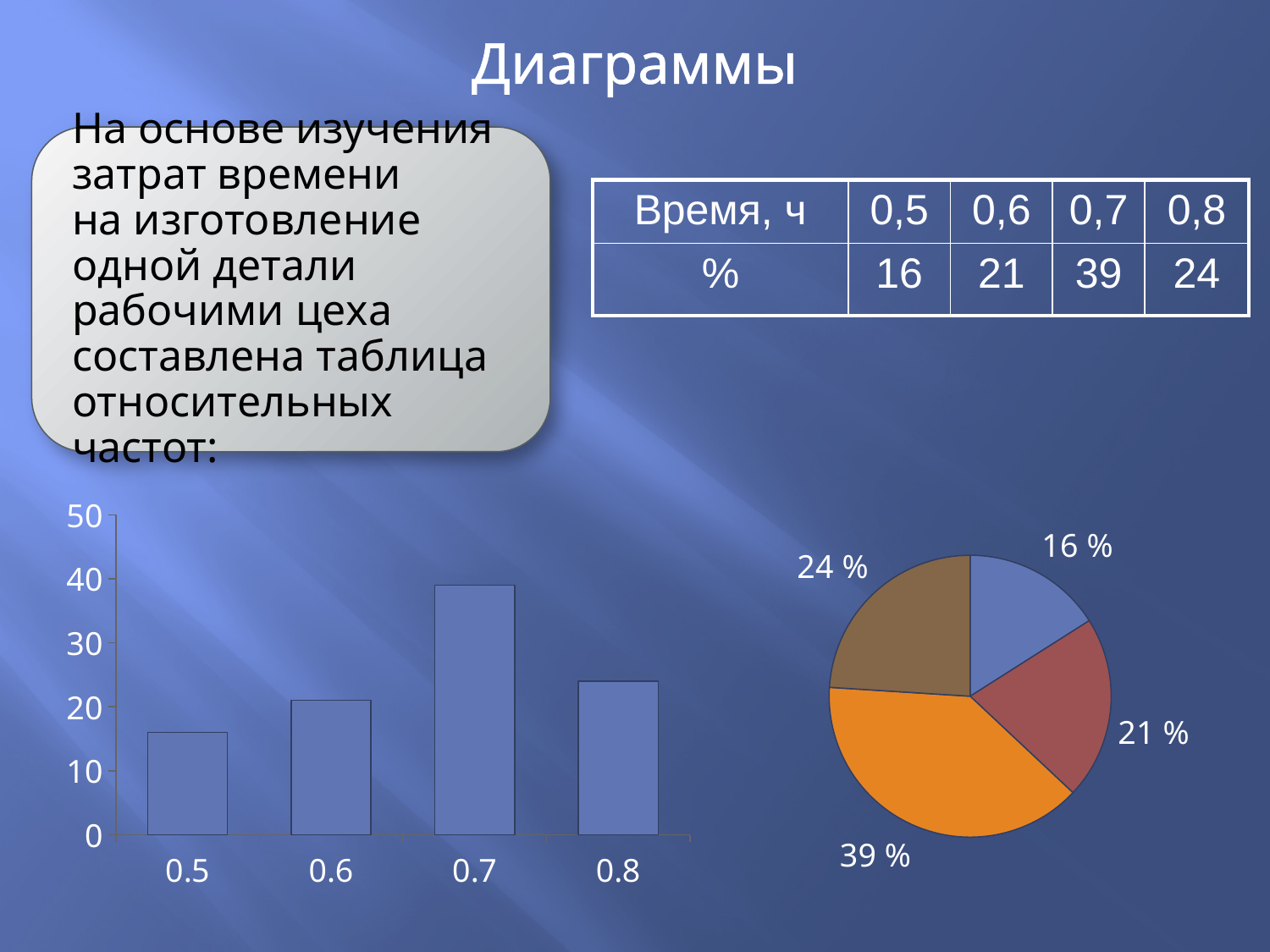
In the pie chart on the bottom right, what is the label of the largest slice? 39 % In the pie chart on the bottom right, what is the label of the smallest slice? 16 % In the bar chart on the bottom left, which category has the shortest bar? 0.5 In the bar chart on the bottom left, how many bars are there? 4 What kind of chart is the chart on the bottom left of the slide? bar chart In the bar chart on the bottom left, is the value for 0.5 greater or less than 20? less In the bar chart on the bottom left, which category has the tallest bar? 0.7 In the bar chart on the bottom left, do the bars rise or fall from 0.5 to 0.7? rise In the bar chart on the bottom left, is the value for 0.7 greater or less than 30? greater In the pie chart on the bottom right, what is the difference between the largest slice and the smallest slice? 23 % In the bar chart on the bottom left, which bar is taller, 0.7 or 0.8? 0.7 What kind of chart is the chart on the bottom right of the slide? pie chart